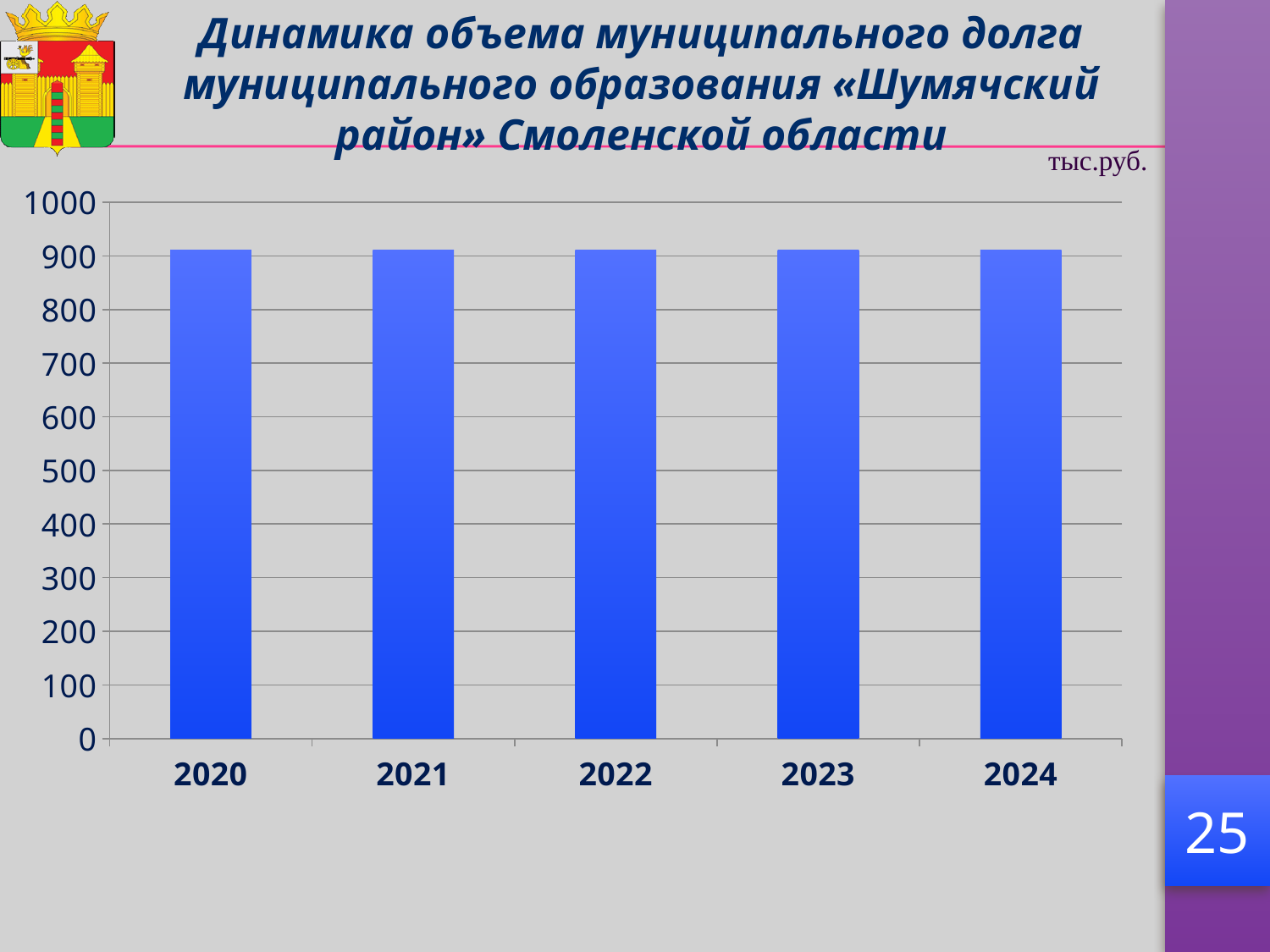
Is the value for 2022 greater or less than 1000? less What is the first year shown on the x axis? 2020 Do the values rise, fall, or stay the same from 2020 to 2024? stay the same Is the value for 2021 greater or less than 700? greater Is the value for 2024 greater or less than 500? greater What kind of chart is shown on the slide? bar chart How many years are shown on the x axis of the chart? 5 What unit is indicated above the chart? тыс.руб.